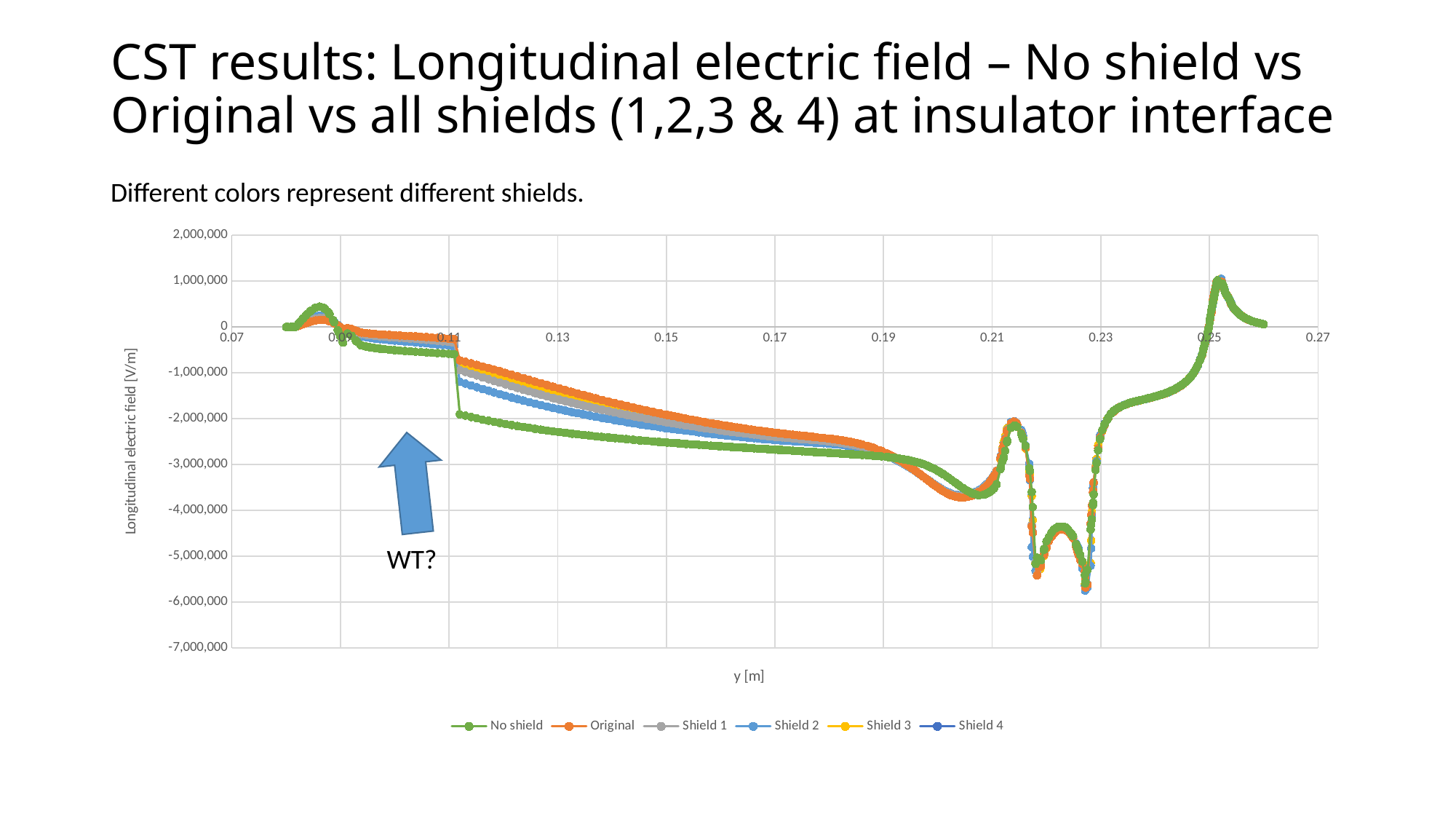
At y = 0.15, which series has the higher value, No shield or Original? Original What is the label of the x axis? y [m] Between y = 0.13 and y = 0.19, do the values of the No shield series rise or fall? fall Is the value of the No shield series at y = 0.13 greater or less than -1,000,000? less Is the value of the No shield series at y = 0.17 greater or less than -3,000,000? greater Is the value of the Original series at y = 0.13 greater or less than -1,000,000? less Between y = 0.23 and y = 0.25, do the values of the curves rise or fall? rise How many series does the legend list? 6 What are the series names listed in the legend? No shield, Original, Shield 1, Shield 2, Shield 3, Shield 4 What kind of chart is shown on the slide? line chart